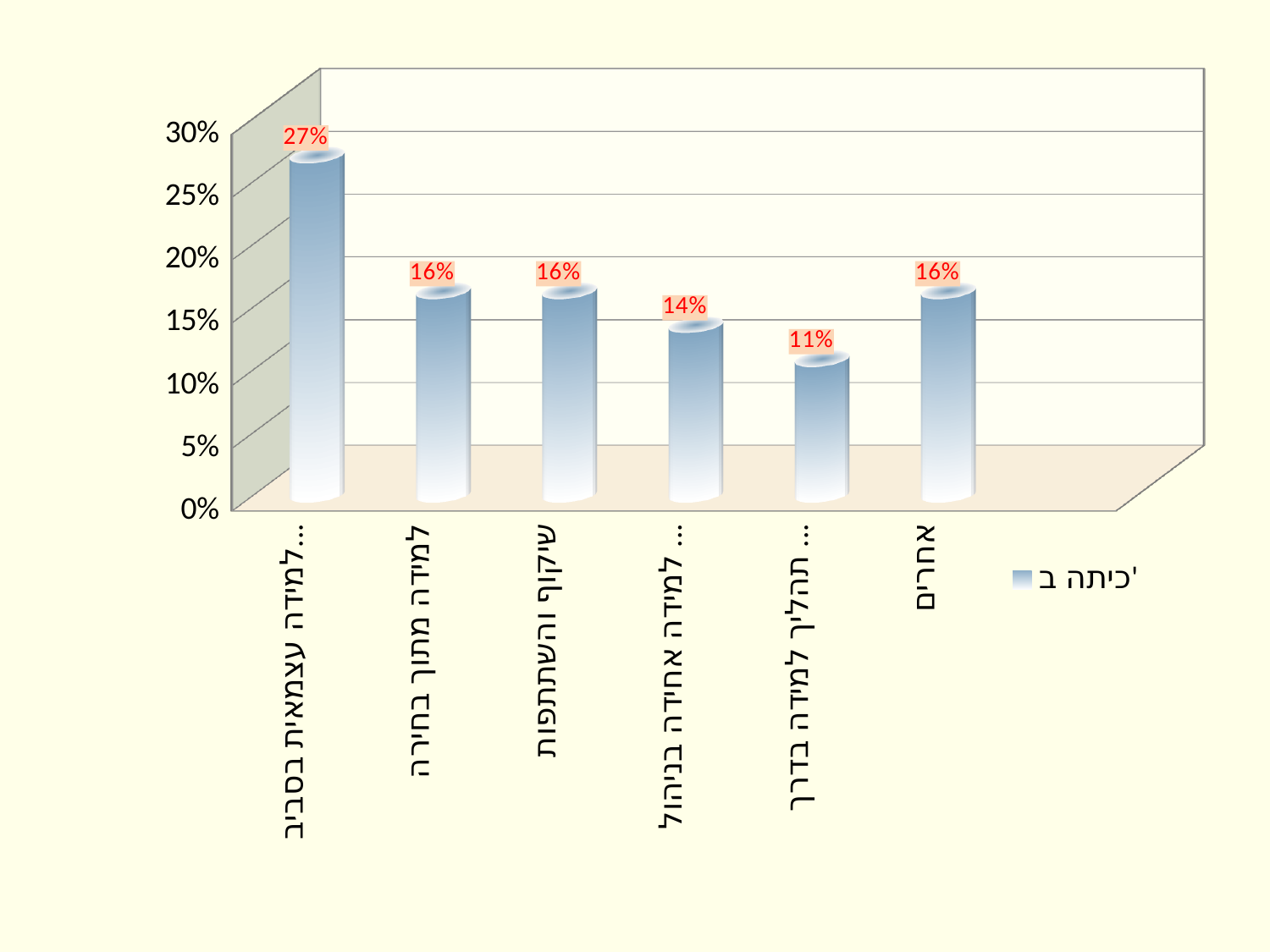
Which is larger, the value for למידה אחידה בניהול... or the value for תהליך למידה בדרך...? למידה אחידה בניהול... What series name does the legend show? כיתה ב' What is the value for למידה מתוך בחירה? 16% How many categories are shown on the x axis? 6 What is the value for אחרים? 16% What is the difference between the leftmost bar (27%) and אחרים? 11% What kind of chart is this? bar chart Which category has the lowest value? תהליך למידה בדרך... What is the value of the leftmost bar (למידה עצמאית בסביב...)? 27% What is the value of the bar labelled תהליך למידה בדרך...? 11% Which category has the highest value? למידה עצמאית בסביב... What is the value for שיקוף והשתתפות? 16%